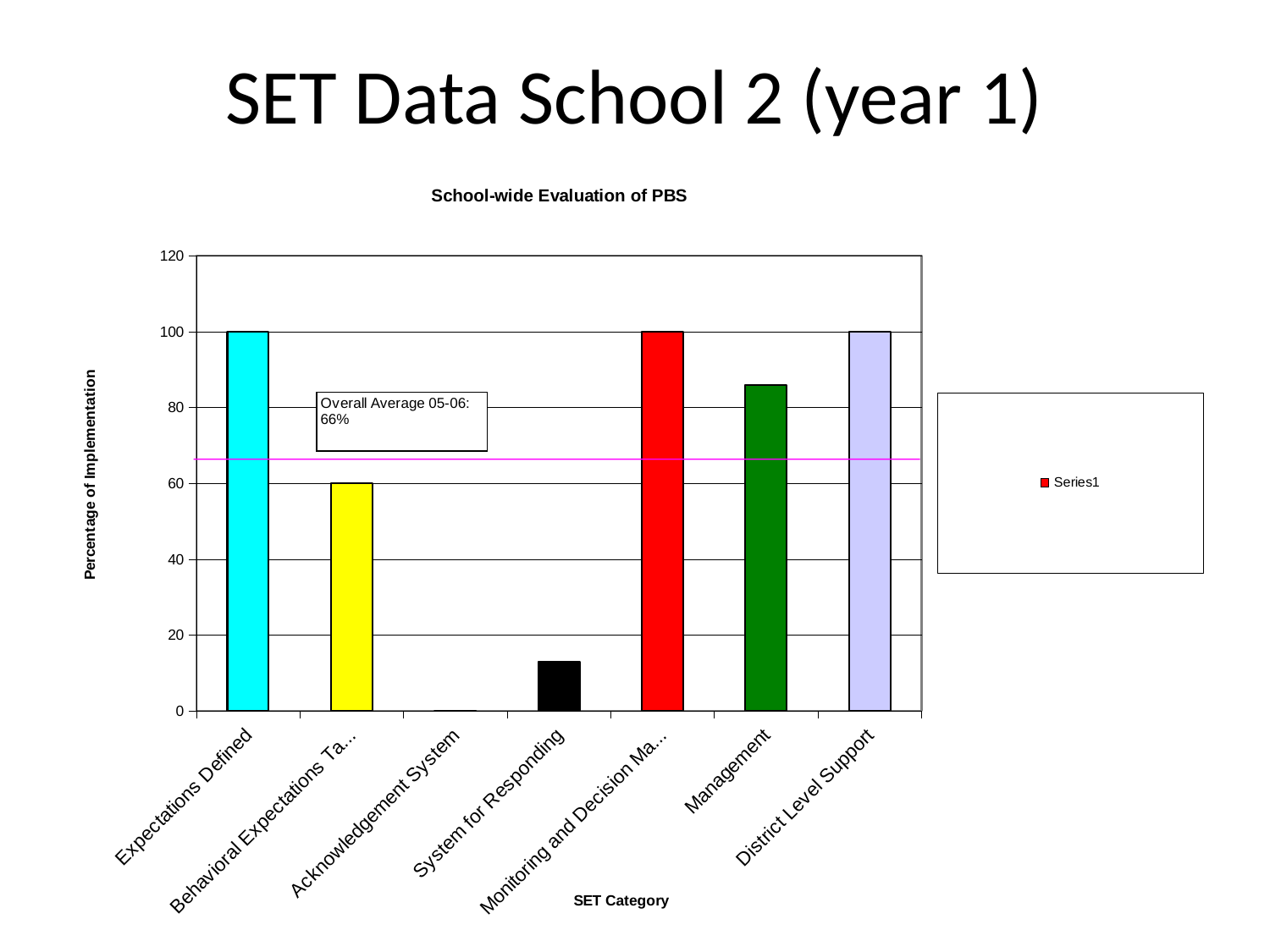
What is the percentage of implementation for Acknowledgement System? 0 How many series does the legend list? 1 How many SET categories are shown on the x axis? 7 What type of chart is shown on the slide? bar chart What overall average for 05-06 is noted on the chart? 66% What is the percentage of implementation for Expectations Defined? 100 What is the title of the chart? School-wide Evaluation of PBS Is the value for System for Responding greater or less than 20? less Which has a higher percentage of implementation, Management or System for Responding? Management Is the value for Management greater or less than 80? greater Which SET category has the lowest percentage of implementation? Acknowledgement System What is the percentage of implementation for District Level Support? 100